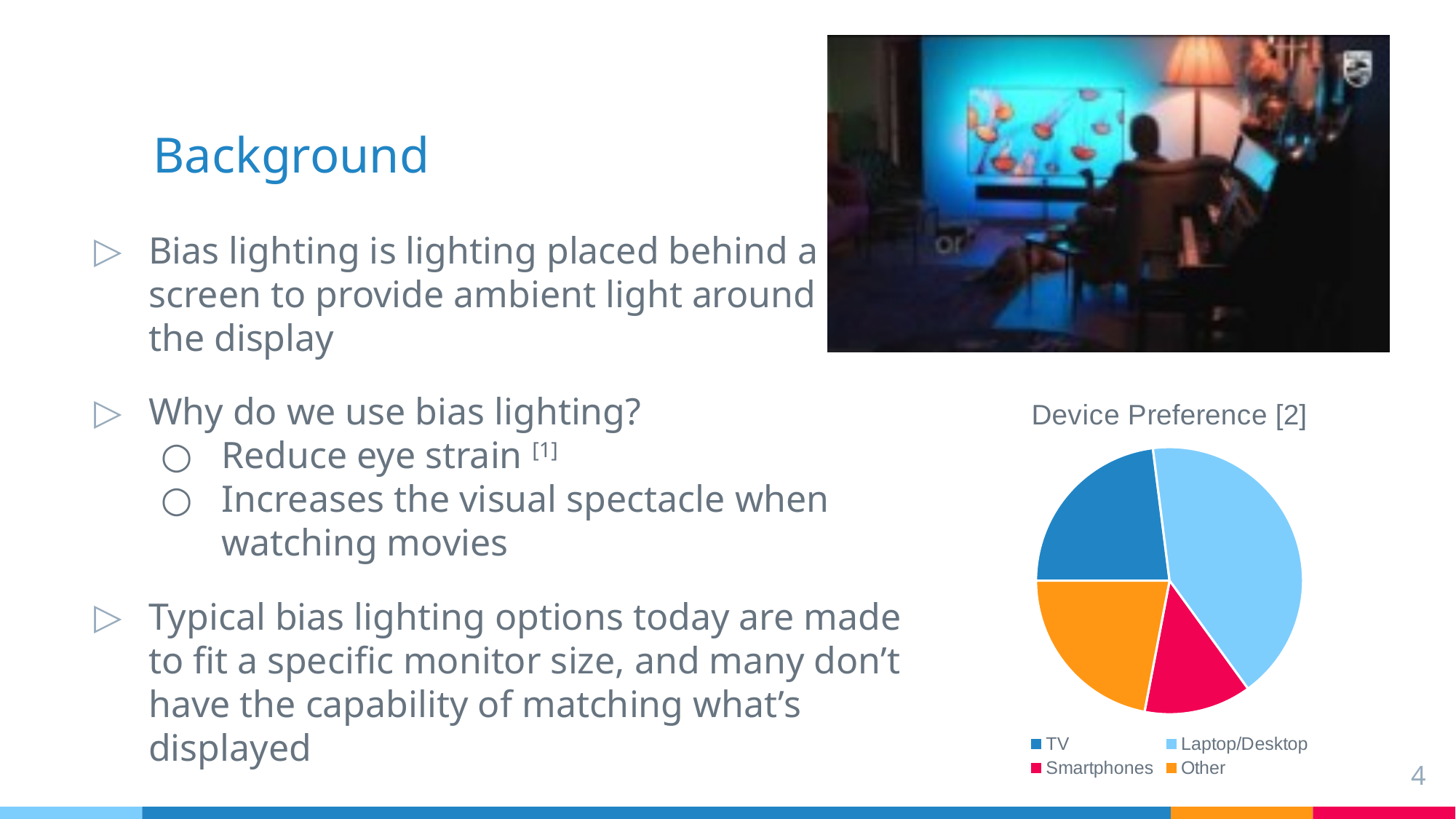
In the Device Preference pie chart, which slice is larger: TV or Smartphones? TV What is the title of the pie chart on the slide? Device Preference [2] In the Device Preference pie chart, which slice is larger: Other or Smartphones? Other How many slices does the Device Preference pie chart have? 4 Which category has the largest slice in the Device Preference pie chart? Laptop/Desktop What kind of chart is shown under the title "Device Preference [2]"? pie chart How many entries does the legend of the Device Preference chart list? 4 Which category is shown in orange in the Device Preference pie chart? Other In the Device Preference pie chart, which slice is larger: Laptop/Desktop or Smartphones? Laptop/Desktop Which category has the smallest slice in the Device Preference pie chart? Smartphones